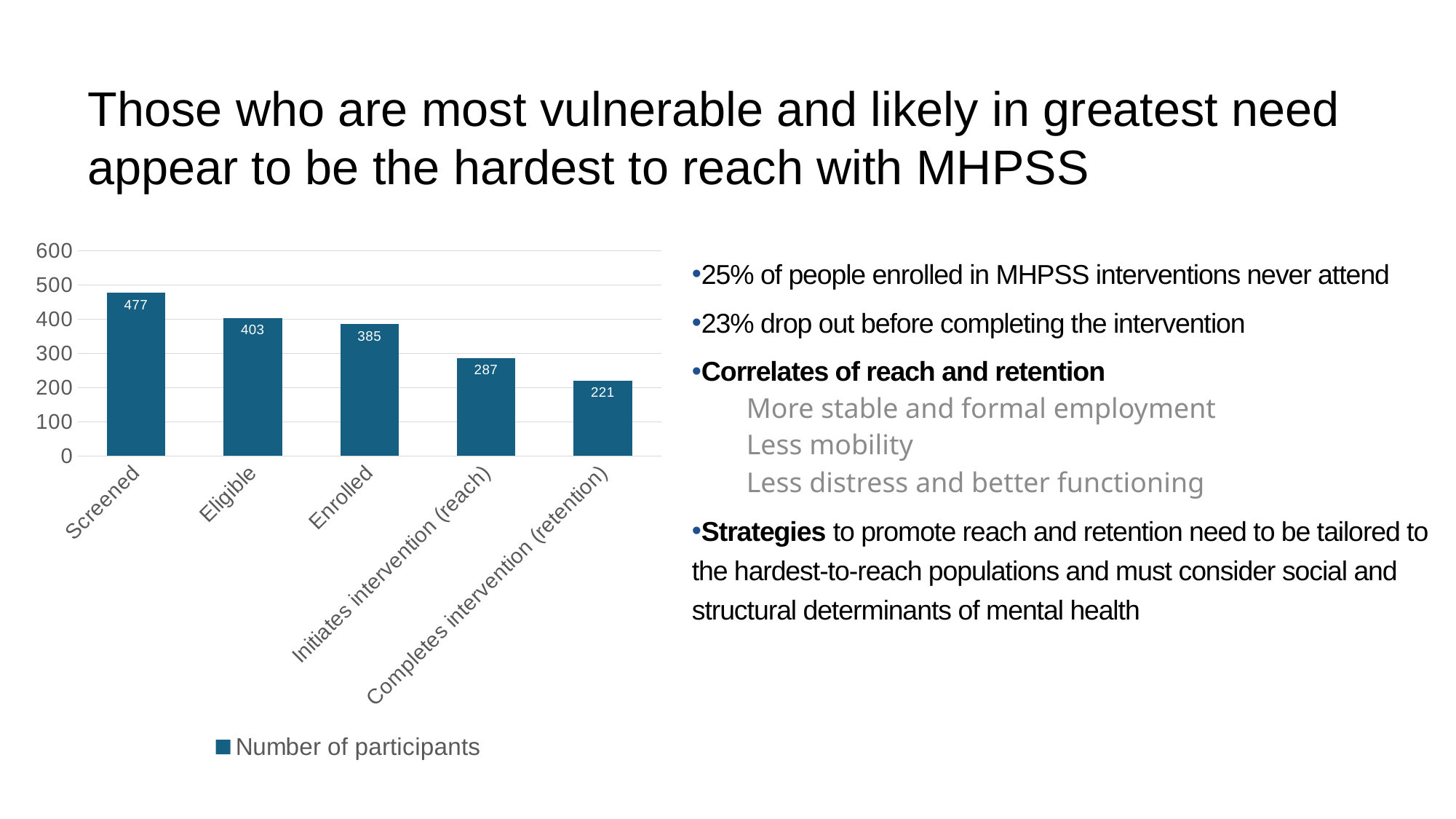
What is the number of participants for Completes intervention (retention)? 221 What is the number of participants for Initiates intervention (reach)? 287 Which category has the lowest number of participants? Completes intervention (retention) Which category has the highest number of participants? Screened What is the difference in number of participants between Screened and Completes intervention (retention)? 256 What is the number of participants for Eligible? 403 What is the number of participants for Screened? 477 What is the number of participants for Enrolled? 385 How many categories are shown on the x axis of the chart? 5 Do the values rise or fall from left to right along the x axis? Fall What kind of chart is shown on the slide? Bar chart Which has more participants, Eligible or Initiates intervention (reach)? Eligible